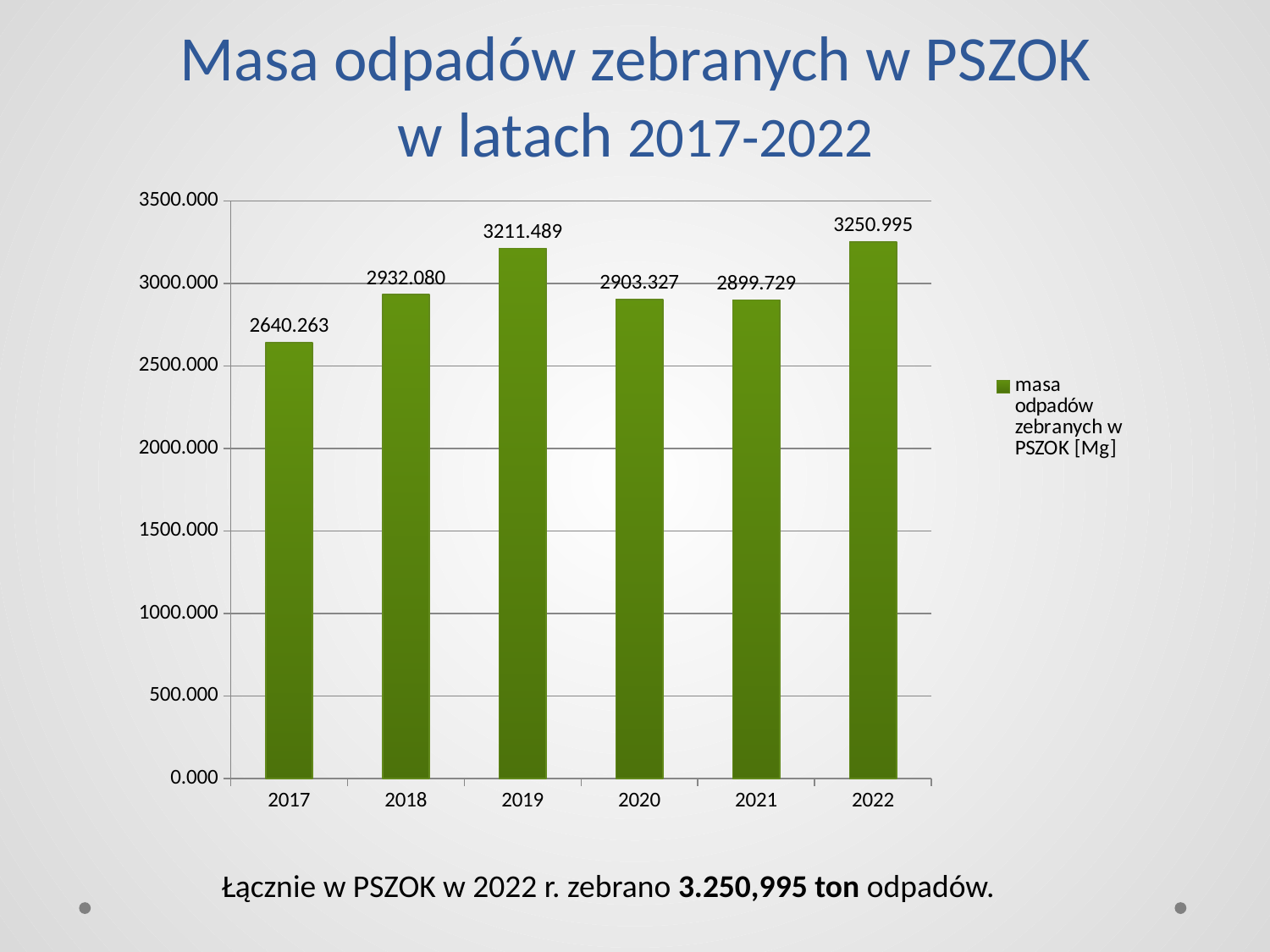
What kind of chart is shown on the slide? bar chart What is the difference between the values for 2019 and 2018? 279.409 Which is larger, the value for 2019 or the value for 2018? 2019 Is the value for 2017 greater or less than 2500.000? greater What is the difference between the values for 2022 and 2017? 610.732 Which year has the highest value? 2022 How many years are shown on the x axis? 6 What is the value for 2017? 2640.263 What is the value for 2022? 3250.995 Which year has the lowest value? 2017 What is the legend entry for the series? masa odpadów zebranych w PSZOK [Mg] What is the value for 2019? 3211.489